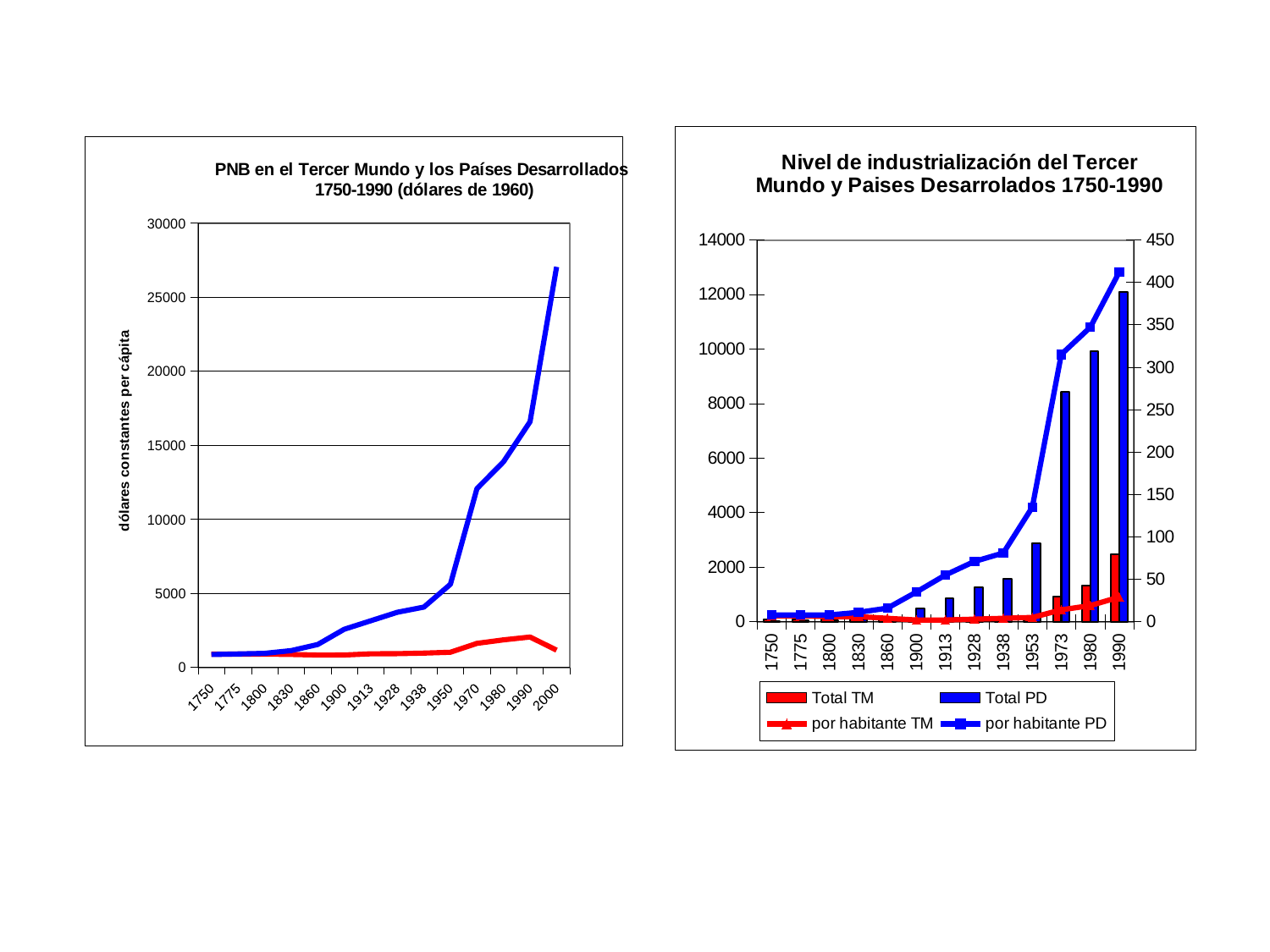
In the left chart (PNB en el Tercer Mundo y los Países Desarrollados), how many years are shown on the x axis? 14 In the left chart (PNB en el Tercer Mundo y los Países Desarrollados), is the value of the blue line at 2000 greater or less than 25000? greater In the right chart (Nivel de industrialización del Tercer Mundo y Paises Desarrolados), which year has the highest Total PD bar? 1990 In the left chart (PNB en el Tercer Mundo y los Países Desarrollados), is the value of the red line at 1990 greater or less than 5000? less In the left chart (PNB en el Tercer Mundo y los Países Desarrollados), does the blue line generally rise or fall from 1750 to 2000? rise What kind of chart is the left chart, 'PNB en el Tercer Mundo y los Países Desarrollados 1750-1990'? line chart In the left chart (PNB en el Tercer Mundo y los Países Desarrollados), what is the label of the vertical axis? dólares constantes per cápita In the right chart (Nivel de industrialización del Tercer Mundo y Paises Desarrolados), is the Total PD bar for 1990 greater or less than 10000? greater In the right chart (Nivel de industrialización del Tercer Mundo y Paises Desarrolados), how many years are shown on the x axis? 13 In the right chart (Nivel de industrialización del Tercer Mundo y Paises Desarrolados), which is larger in 1990, the Total PD bar or the Total TM bar? Total PD In the right chart (Nivel de industrialización del Tercer Mundo y Paises Desarrolados), how many series does the legend list? 4